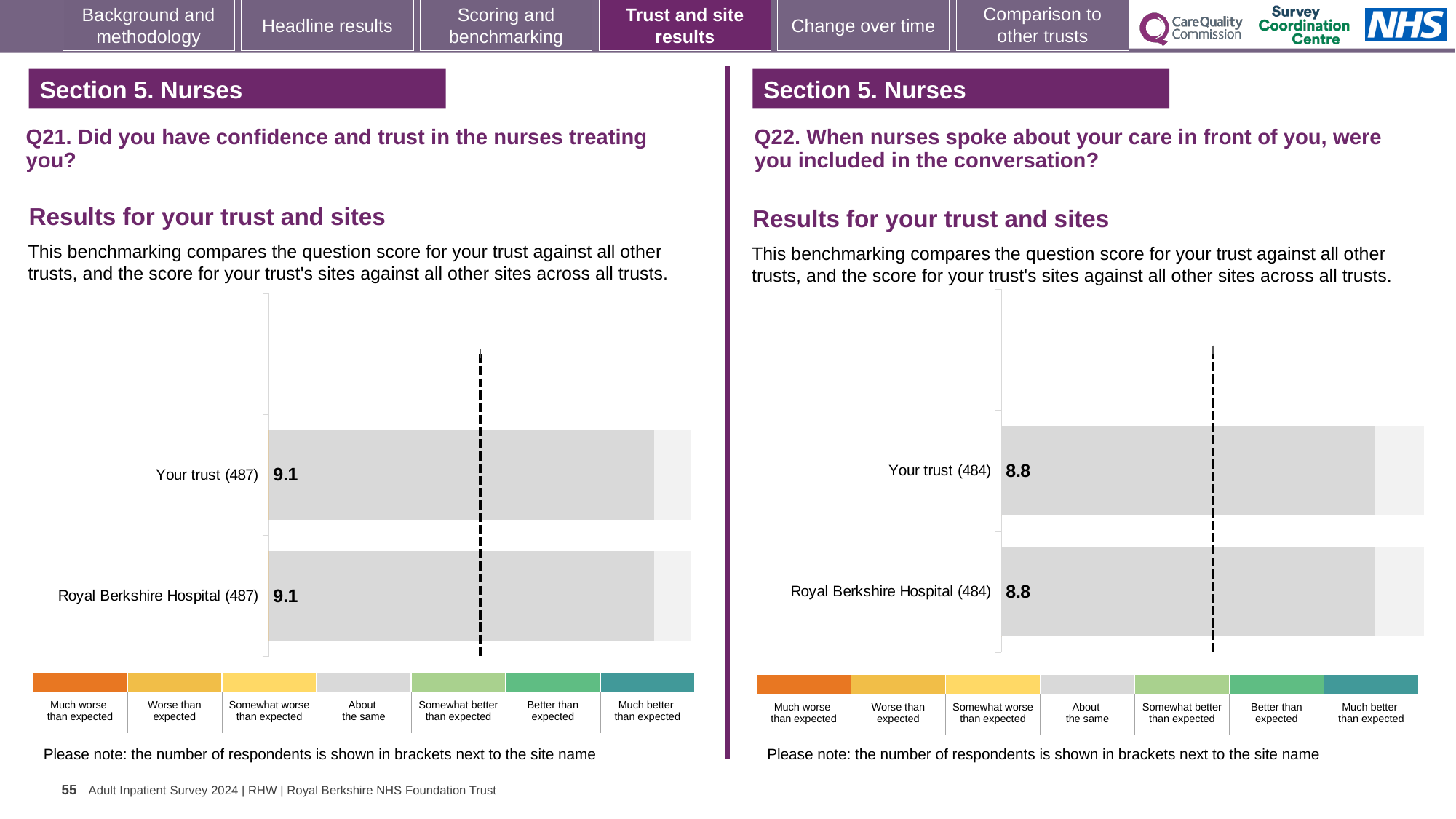
In the Q21 chart on the left, what is the score for Your trust? 9.1 In the Q22 chart on the right, what is the score for Royal Berkshire Hospital? 8.8 Which is larger: the Your trust score in the Q21 chart on the left or the Your trust score in the Q22 chart on the right? Q21 chart (9.1) What is the difference between the Your trust score in the Q21 chart and the Your trust score in the Q22 chart? 0.3 How many bars are plotted in the Q22 chart on the right? 2 In the Q21 chart on the left, what is the score for Royal Berkshire Hospital? 9.1 In the Q21 chart on the left, how many respondents are shown in brackets for Your trust? 487 In the Q22 chart on the right, how many respondents are shown in brackets for Royal Berkshire Hospital? 484 What kind of chart is used for the Q21 results on the left? Bar chart In the Q22 chart on the right, what is the score for Your trust? 8.8 How many bars are plotted in the Q21 chart on the left? 2 How many benchmark categories are shown in the colour key below the Q22 chart on the right? 7